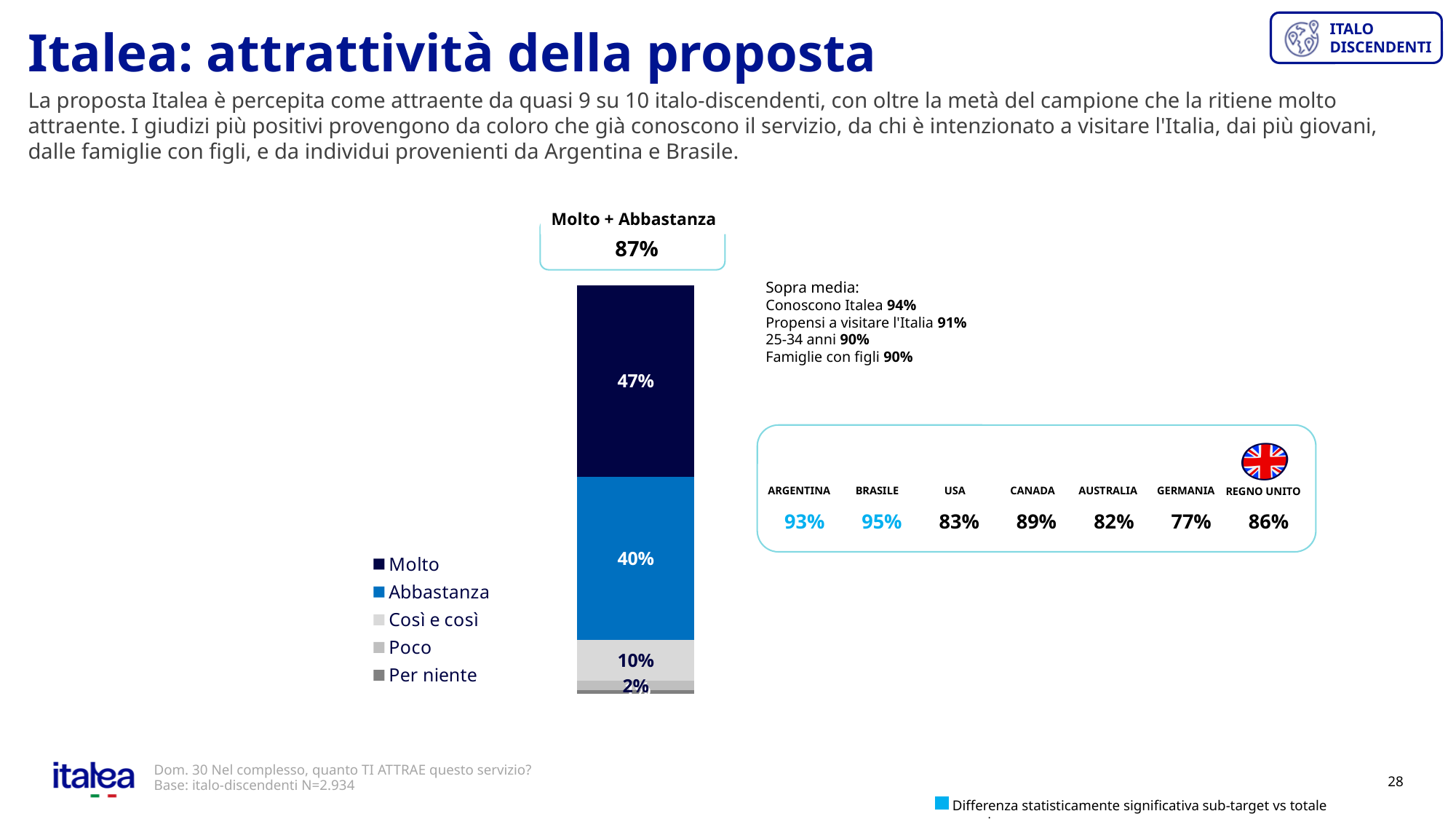
What percentage of respondents answered "Molto" in the stacked bar chart? 47% What is the combined total of the "Molto" and "Abbastanza" segments, as shown in the callout above the bar? 87% What is the difference between the "Abbastanza" and "Così e così" segments? 30 percentage points How many series does the chart legend list? 5 What value is shown for the "Poco" segment of the bar? 2% What colour is used for the "Molto" segment in the chart? Dark navy blue What is the value of the "Abbastanza" segment in the stacked bar? 40% What is the difference between the "Molto" and "Abbastanza" segments? 7 percentage points What kind of chart is shown on the slide? Stacked bar chart Which segment is larger, "Molto" or "Abbastanza"? Molto What value is shown for the "Così e così" segment? 10% Which response category has the largest segment in the stacked bar? Molto